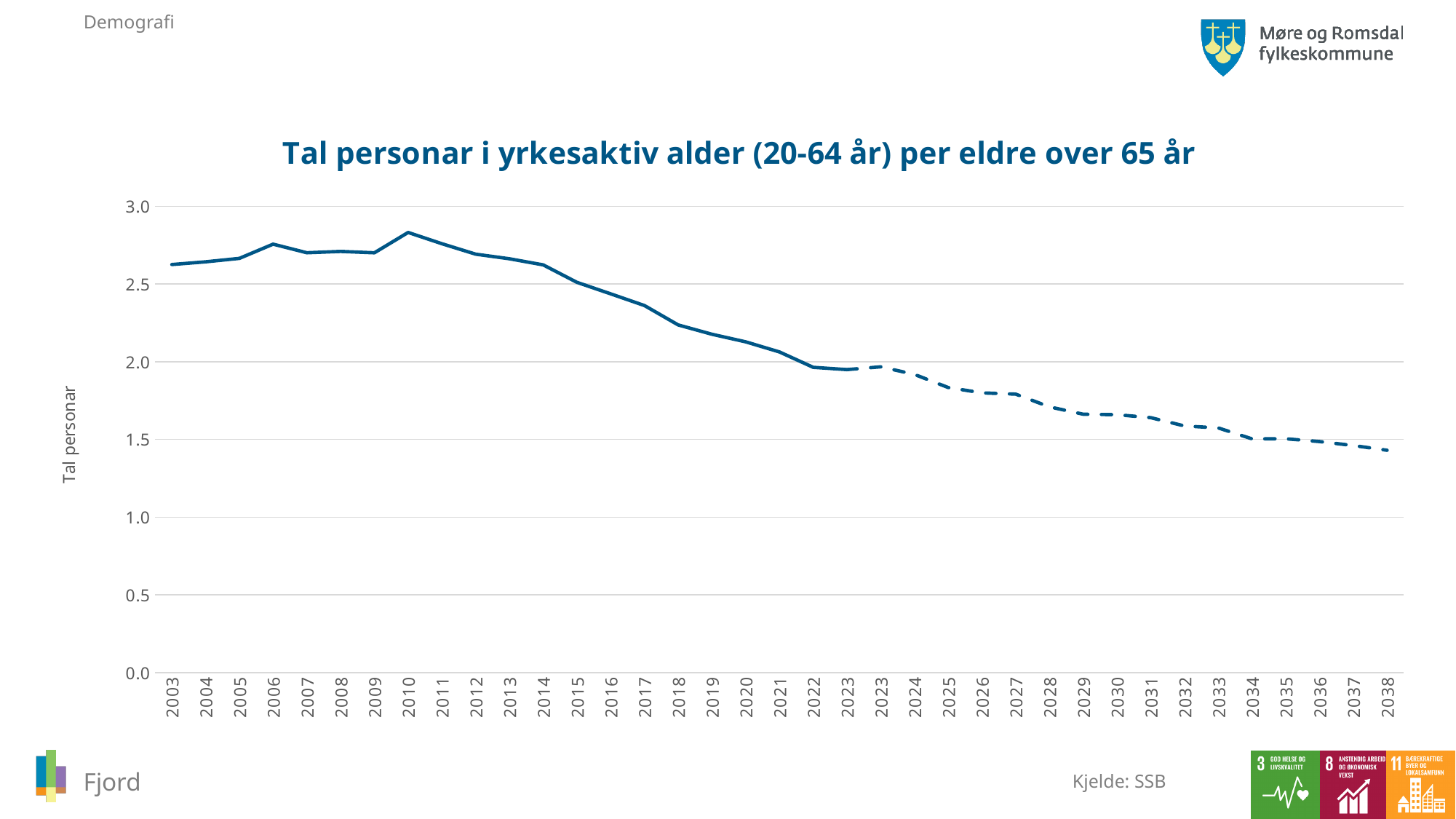
What is the title of the chart? Tal personar i yrkesaktiv alder (20-64 år) per eldre over 65 år Which year has the larger value, 2003 or 2038? 2003 Which year has the larger value, 2010 or 2020? 2010 In which year does the line reach its lowest value? 2038 Is the value for 2003 greater or less than 2.5? greater Is the value for 2030 greater or less than 1.5? greater Do the values generally rise or fall from 2010 to 2038? fall What kind of chart is shown on the slide? line chart Is the value for 2038 greater or less than 1.5? less What is the label on the y axis of the chart? Tal personar In which year does the line reach its highest value? 2010